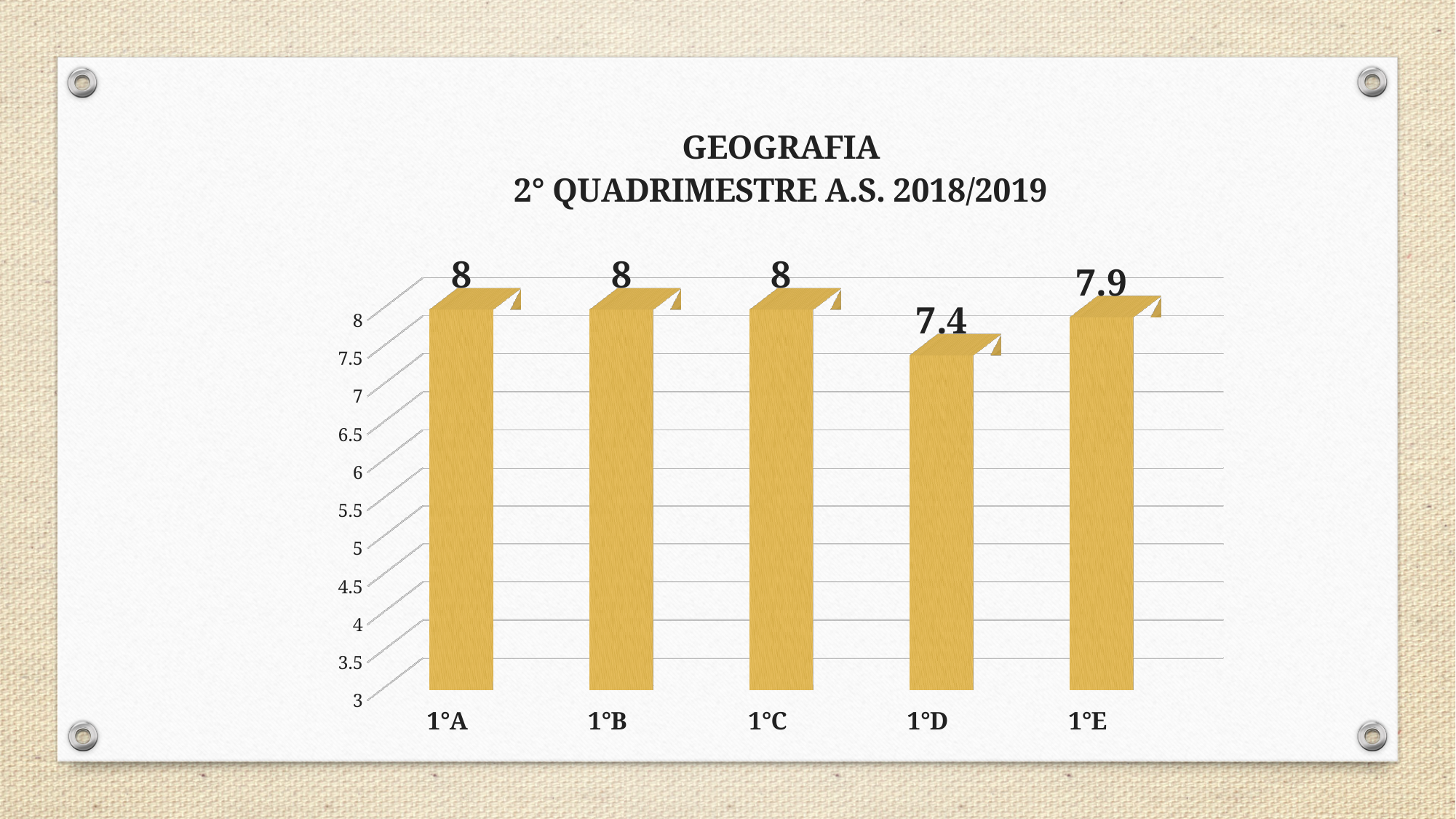
What is the difference between the values for 1°A and 1°D? 0.6 What is the difference between the values for 1°E and 1°D? 0.5 What is the title of the chart? GEOGRAFIA 2° QUADRIMESTRE A.S. 2018/2019 Is the value for 1°D greater or less than 7.5? less Which category has the lowest value? 1°D Which is larger, the value for 1°D or the value for 1°E? 1°E What kind of chart is shown on the slide? bar chart What is the value for 1°D? 7.4 What is the value for 1°E? 7.9 What is the value for 1°A? 8 How many categories are shown on the x axis? 5 Which is larger, the value for 1°C or the value for 1°E? 1°C